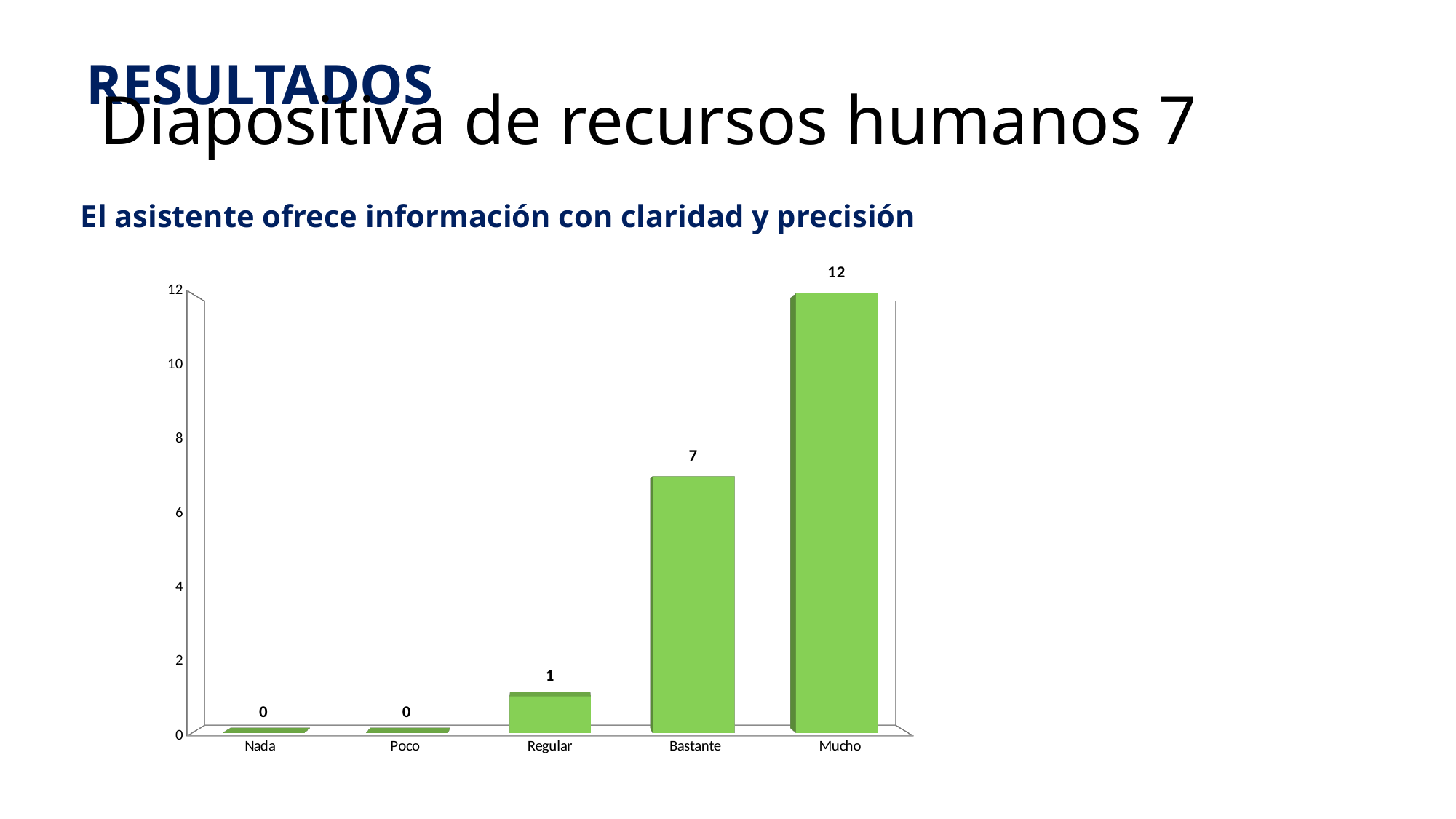
How many categories are shown on the x axis? 5 What is the value for Regular? 1 What is the value for Nada? 0 What is the value for Bastante? 7 Do the values rise or fall from Nada to Mucho along the x axis? rise Is the value for Bastante greater or less than 6? greater What is the difference between the values for Mucho and Bastante? 5 Which is larger, the value for Regular or the value for Bastante? Bastante What is the value for Mucho? 12 What is the heading shown above the chart? El asistente ofrece información con claridad y precisión Which category has the highest value? Mucho What kind of chart is shown on the slide? bar chart